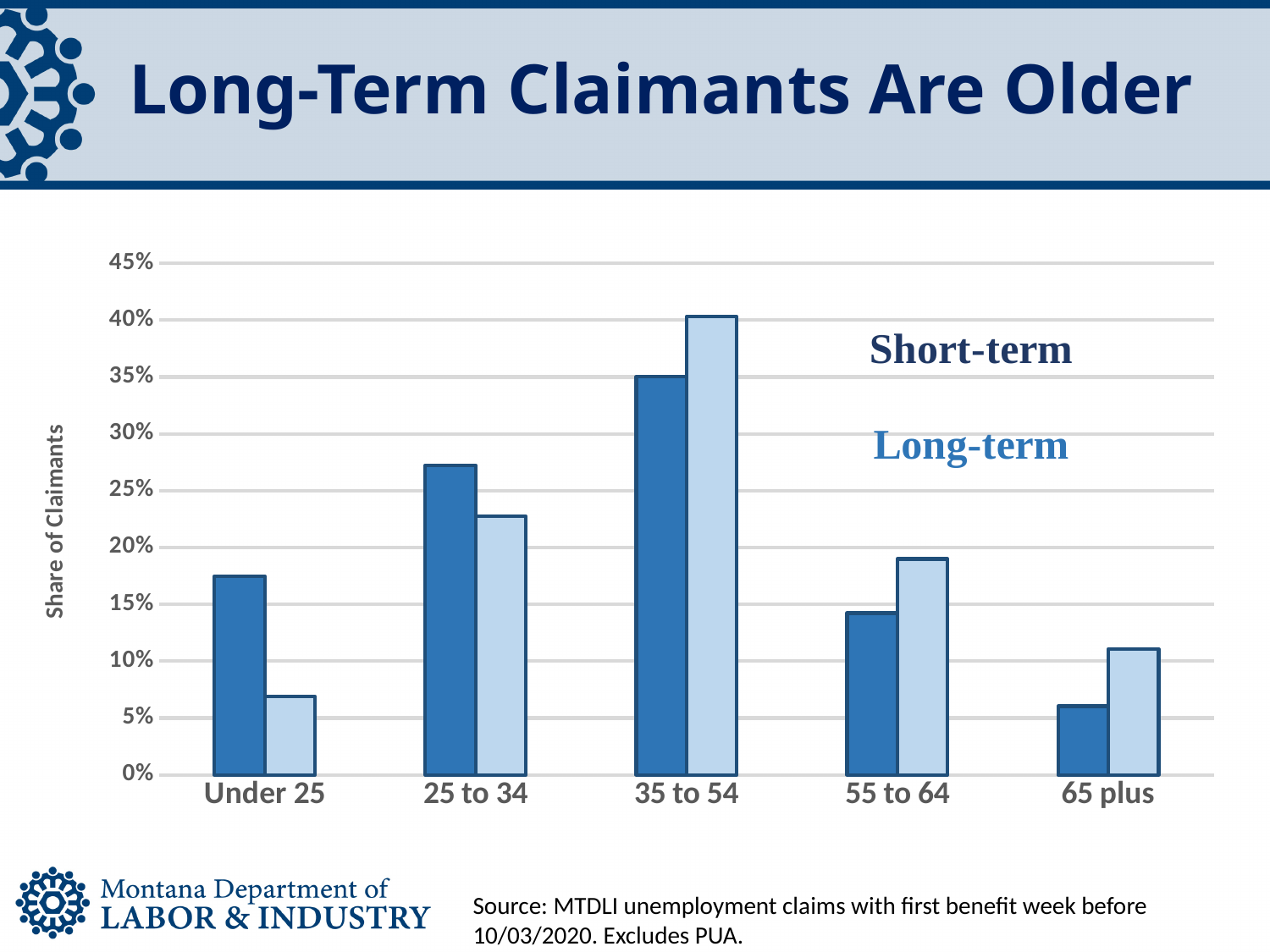
Which age group has the lowest Long-term share of claimants? Under 25 What is the label on the vertical axis? Share of Claimants How many series does the chart show? 2 For the Under 25 group, which is larger: the Short-term or the Long-term share? Short-term How many age categories are shown on the x axis? 5 Which age group has the highest Short-term share of claimants? 35 to 54 What kind of chart is shown on the slide? bar chart Is the Long-term value for Under 25 greater or less than 10%? less Is the Long-term value for 35 to 54 greater or less than 35%? greater For the 65 plus group, which is larger: the Short-term or the Long-term share? Long-term Which age group has the highest Long-term share of claimants? 35 to 54 Which age group has the lowest Short-term share of claimants? 65 plus